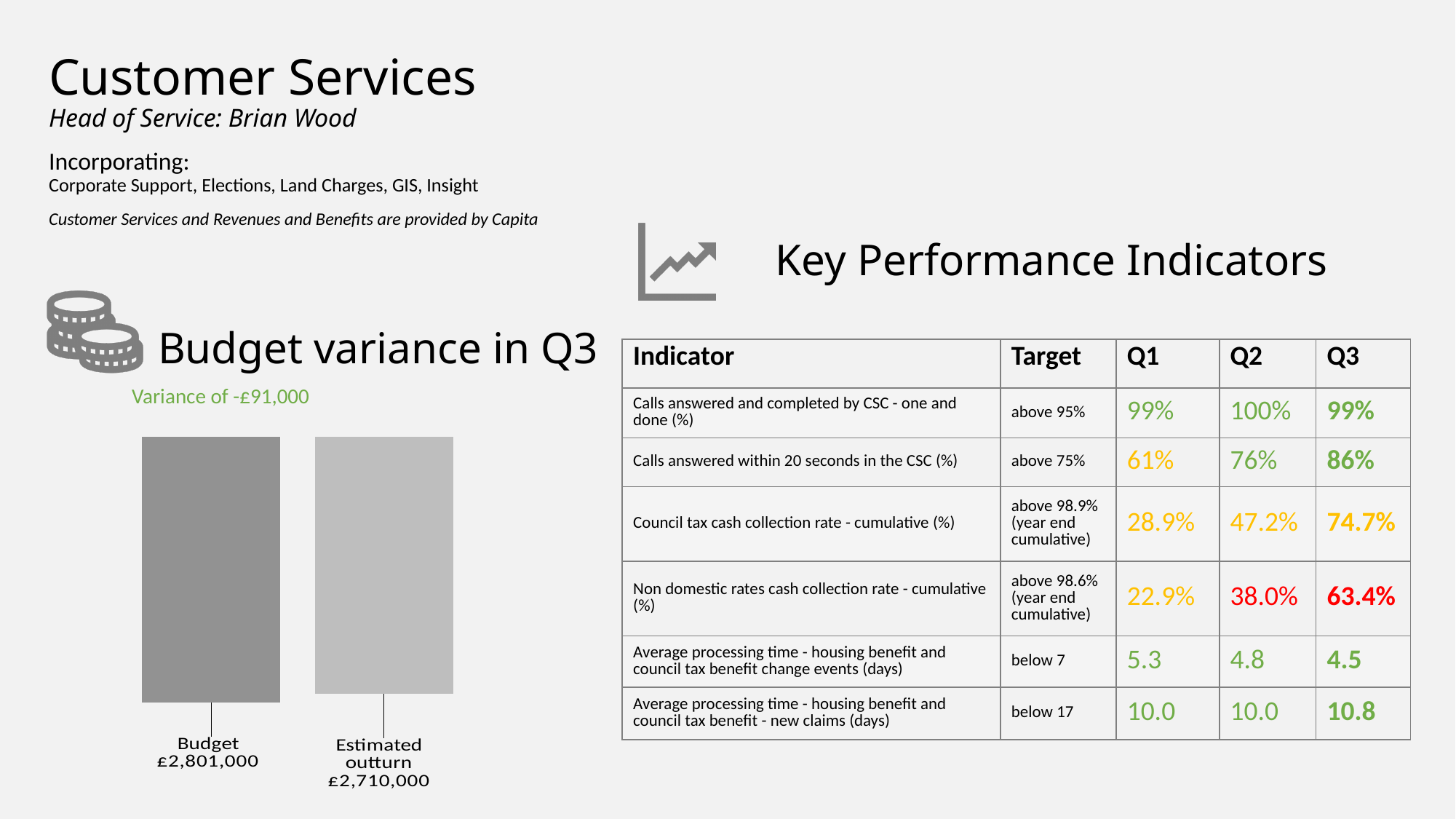
What is the difference between the Budget and the Estimated outturn in the budget variance chart? £91,000 What type of chart is shown under the 'Budget variance in Q3' heading? bar chart What is the heading of the bar chart on the left of the slide? Budget variance in Q3 What variance is stated above the budget variance chart? Variance of -£91,000 What is the value of the Budget bar in the budget variance chart? £2,801,000 Which bar in the budget variance chart is the highest? Budget Do the values in the budget variance chart rise or fall from the Budget bar to the Estimated outturn bar? fall What is the value of the Estimated outturn bar in the budget variance chart? £2,710,000 How many bars are plotted in the budget variance chart? 2 In the budget variance chart, is the Budget larger or smaller than the Estimated outturn? larger Which bar in the budget variance chart is the lowest? Estimated outturn